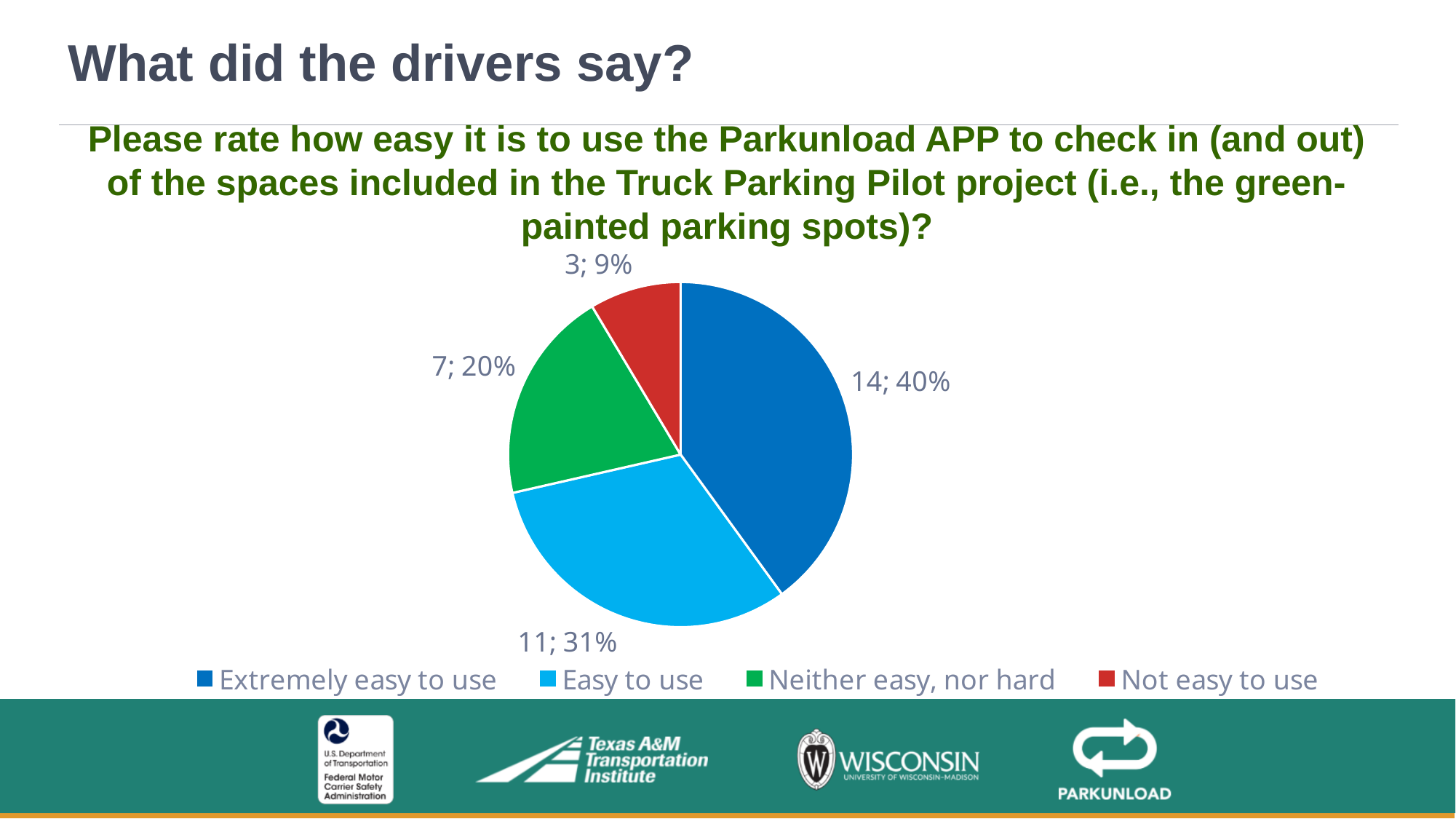
What kind of chart is shown on the slide? pie chart Which response category has the largest share of the pie? Extremely easy to use What percentage of respondents chose "Neither easy, nor hard"? 20% How many response categories does the legend list? 4 How many respondents said the Parkunload APP was "Extremely easy to use"? 14 What colour is the "Not easy to use" slice? red Which response category has the smallest share of the pie? Not easy to use What is the total number of respondents across all four categories? 35 Which has more respondents: "Neither easy, nor hard" or "Not easy to use"? Neither easy, nor hard How many more respondents chose "Extremely easy to use" than "Easy to use"? 3 What percentage of respondents said the app was "Easy to use"? 31% How many respondents said the app was "Not easy to use"? 3